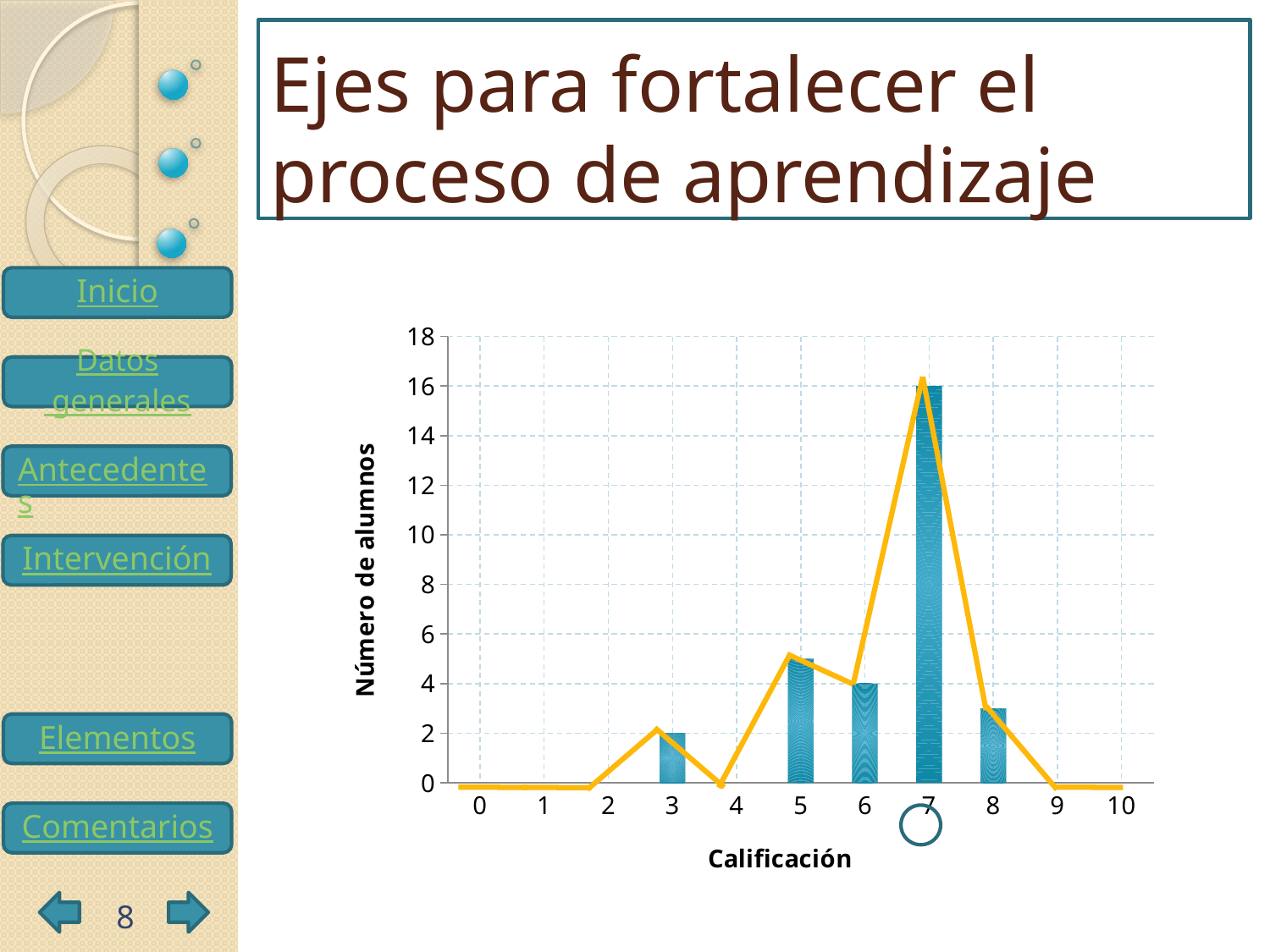
Which has more students: Calificación 5 or Calificación 6? Calificación 5 What is the difference between the number of students with a Calificación of 7 and those with a Calificación of 6? 12 What kind of chart is shown on the slide? bar chart with a line overlay What is the title of the y axis? Número de alumnos Which Calificación has the highest number of students? 7 How many students have a Calificación of 3? 2 Is the number of students with a Calificación of 5 greater or less than 4? greater How many students have a Calificación of 6? 4 What is the title of the x axis? Calificación How many students (Número de alumnos) have a Calificación of 7? 16 Is the number of students with a Calificación of 8 greater or less than 4? less How many Calificación values are marked on the x axis? 11